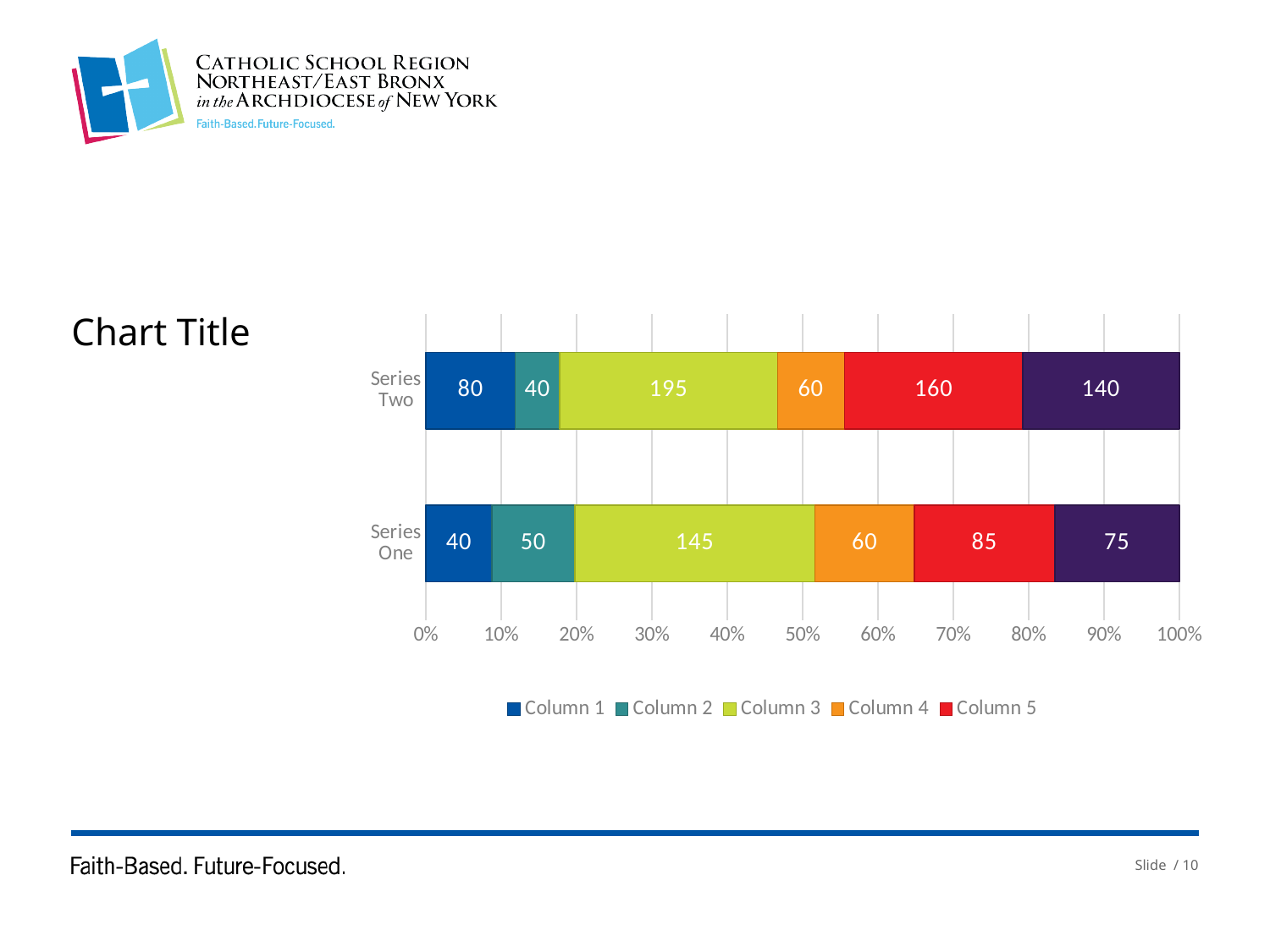
Which segment has the largest value in the Series One bar? Column 3 What kind of chart is shown on the slide? Stacked bar chart Which has the larger Column 1 value, Series One or Series Two? Series Two How many series does the legend list? 5 How many categories (bars) are shown on the chart? 2 What is the value of Column 3 for Series Two? 195 What is the difference between the Column 3 values for Series Two and Series One? 50 What is the total of all segments in the Series Two bar? 675 What is the value of Column 5 for Series Two? 160 What is the value of Column 1 for Series One? 40 What is the value of Column 4 for Series One? 60 What is the total of all segments in the Series One bar? 455